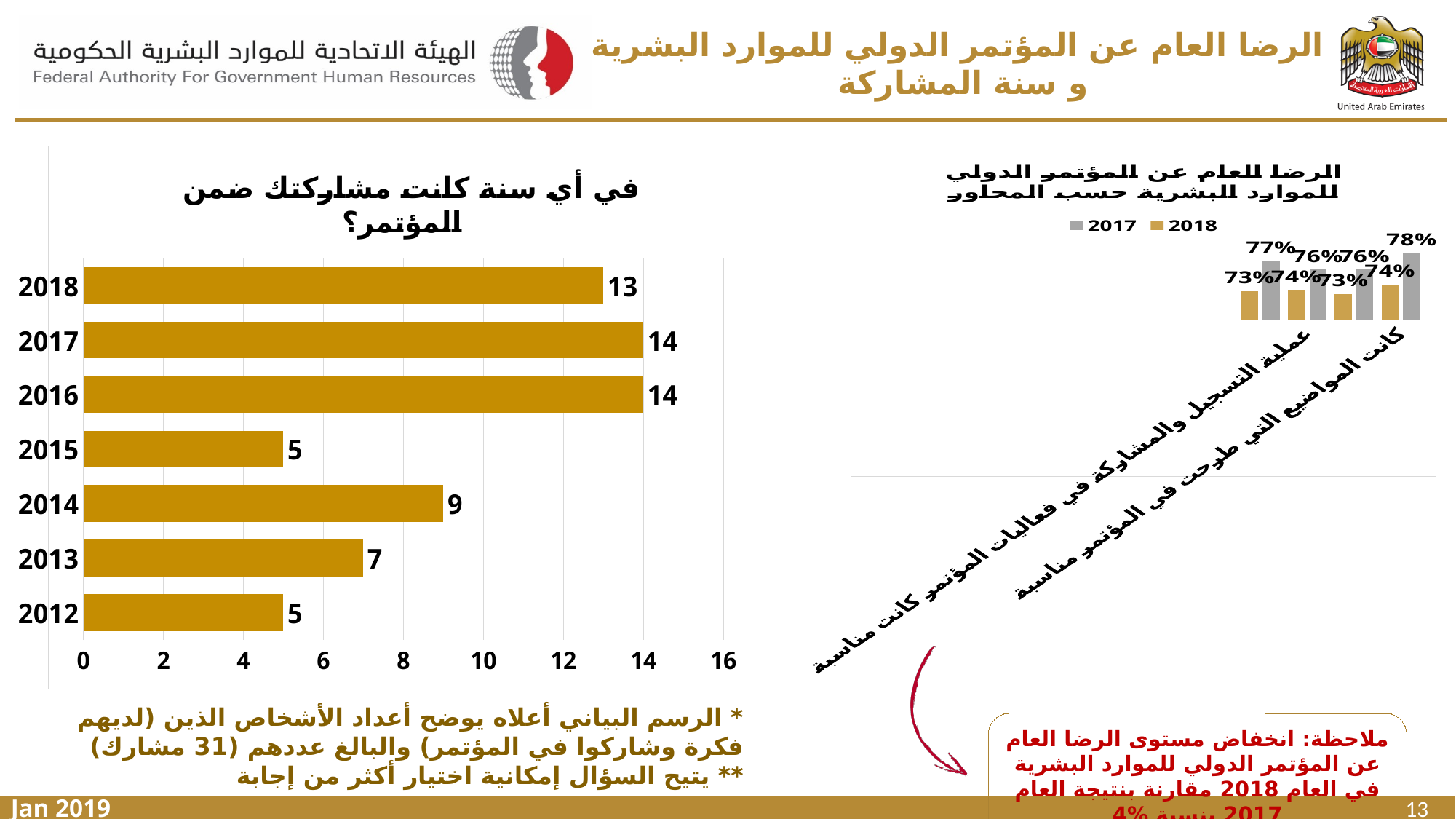
In the left chart 'في أي سنة كانت مشاركتك ضمن المؤتمر؟', which is larger, the value for 2014 or the value for 2015? 2014 In the left chart 'في أي سنة كانت مشاركتك ضمن المؤتمر؟', what is the value for 2013? 7 In the right chart 'الرضا العام عن المؤتمر الدولي للموارد البشرية حسب المحاور', which years are listed in the legend? 2017 and 2018 In the left chart 'في أي سنة كانت مشاركتك ضمن المؤتمر؟', which year has the lowest value? 2012 and 2015 (both 5) In the right chart 'الرضا العام عن المؤتمر الدولي للموارد البشرية حسب المحاور', what is the highest value shown on any bar? 78% What kind of chart is the left chart 'في أي سنة كانت مشاركتك ضمن المؤتمر؟'? Bar chart In the left chart 'في أي سنة كانت مشاركتك ضمن المؤتمر؟', what is the value for 2014? 9 In the right chart 'الرضا العام عن المؤتمر الدولي للموارد البشرية حسب المحاور', how many series does the legend list? 2 In the left chart 'في أي سنة كانت مشاركتك ضمن المؤتمر؟', what is the value for 2018? 13 In the left chart 'في أي سنة كانت مشاركتك ضمن المؤتمر؟', how many years are shown? 7 In the left chart 'في أي سنة كانت مشاركتك ضمن المؤتمر؟', what is the difference between the values for 2017 and 2018? 1 In the left chart 'في أي سنة كانت مشاركتك ضمن المؤتمر؟', what is the difference between the values for 2014 and 2013? 2